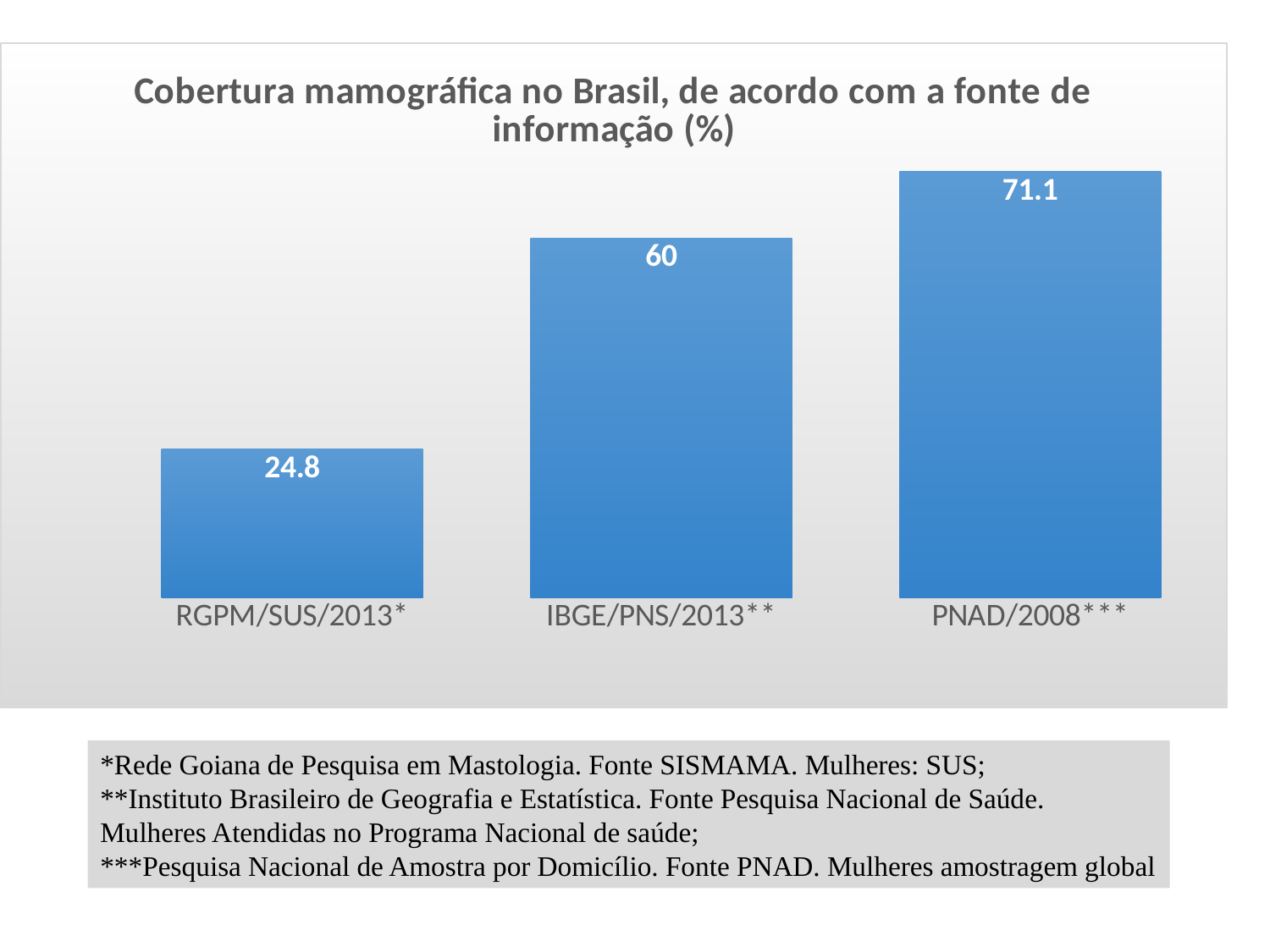
What is the value for RGPM/SUS/2013*? 24.8 What is the value for PNAD/2008***? 71.1 Which category has the lowest value? RGPM/SUS/2013* Which category has the highest value? PNAD/2008*** What is the difference between the values for PNAD/2008*** and IBGE/PNS/2013**? 11.1 What kind of chart is shown on the slide? Bar chart What is the title of the chart? Cobertura mamográfica no Brasil, de acordo com a fonte de informação (%) How many categories are shown in the chart? 3 Do the values rise or fall from left to right across the categories? Rise Which is larger, the value for IBGE/PNS/2013** or the value for RGPM/SUS/2013*? IBGE/PNS/2013** What is the difference between the values for PNAD/2008*** and RGPM/SUS/2013*? 46.3 What is the value for IBGE/PNS/2013**? 60